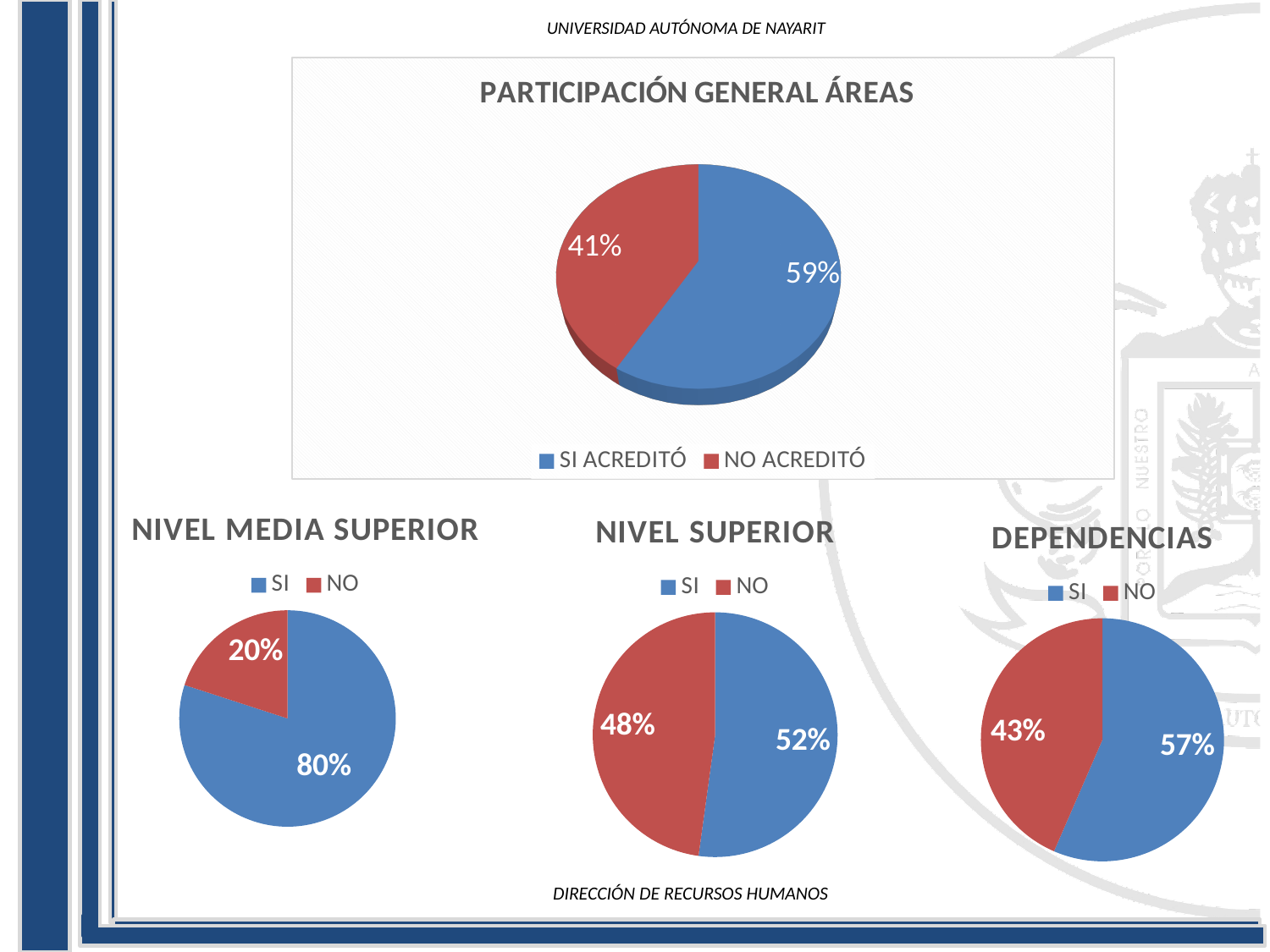
In the PARTICIPACIÓN GENERAL ÁREAS chart, what percentage is shown for SI ACREDITÓ? 59% In the PARTICIPACIÓN GENERAL ÁREAS chart, what is the difference between SI ACREDITÓ and NO ACREDITÓ? 18% In the NIVEL MEDIA SUPERIOR chart, what percentage is shown for NO? 20% In the DEPENDENCIAS chart, what percentage is shown for SI? 57% In the PARTICIPACIÓN GENERAL ÁREAS chart, what colour is the SI ACREDITÓ slice? Blue In the NIVEL MEDIA SUPERIOR chart, what percentage is shown for SI? 80% In the NIVEL SUPERIOR chart, what percentage is shown for NO? 48% How many slices does the DEPENDENCIAS chart have? 2 In the PARTICIPACIÓN GENERAL ÁREAS chart, what percentage is shown for NO ACREDITÓ? 41% In the NIVEL MEDIA SUPERIOR chart, what is the difference between the SI and NO percentages? 60% In the DEPENDENCIAS chart, which slice is larger, SI or NO? SI What kind of chart is the NIVEL SUPERIOR chart? Pie chart